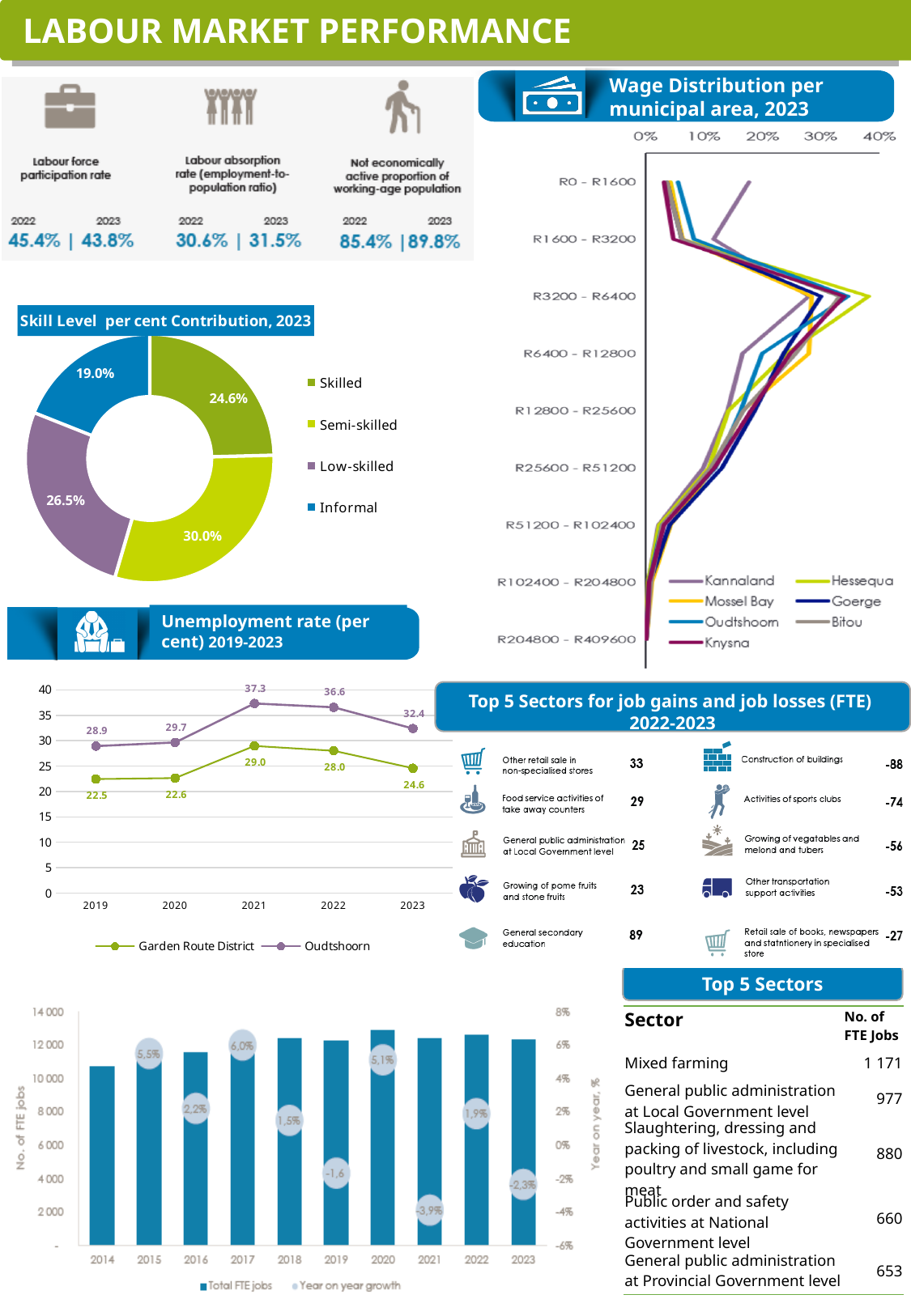
What type of chart is the Wage Distribution per municipal area, 2023 chart? Line chart In the Unemployment rate (per cent) 2019-2023 chart, how many series does the legend list? 2 In the Skill Level per cent Contribution, 2023 chart, which skill level has the smallest share? Informal In the Wage Distribution per municipal area, 2023 chart, how many municipal areas does the legend list? 7 In the Unemployment rate (per cent) 2019-2023 chart, in which year was the Garden Route District unemployment rate highest? 2021 In the Skill Level per cent Contribution, 2023 chart, what share does Semi-skilled contribute? 30.0% In the Unemployment rate (per cent) 2019-2023 chart, how much higher was Oudtshoorn's rate than the Garden Route District's in 2023? 7.8 In the FTE jobs chart at the bottom left, is the number of Total FTE jobs in 2014 greater or less than 12 000? less In the Skill Level per cent Contribution, 2023 chart, how many skill-level categories are shown? 4 In the FTE jobs chart at the bottom left, what was the year on year growth in 2017? 6,0% In the Skill Level per cent Contribution, 2023 chart, what is the difference between the Low-skilled and Skilled shares? 1.9% In the Unemployment rate (per cent) 2019-2023 chart, what was the unemployment rate for Oudtshoorn in 2021? 37.3